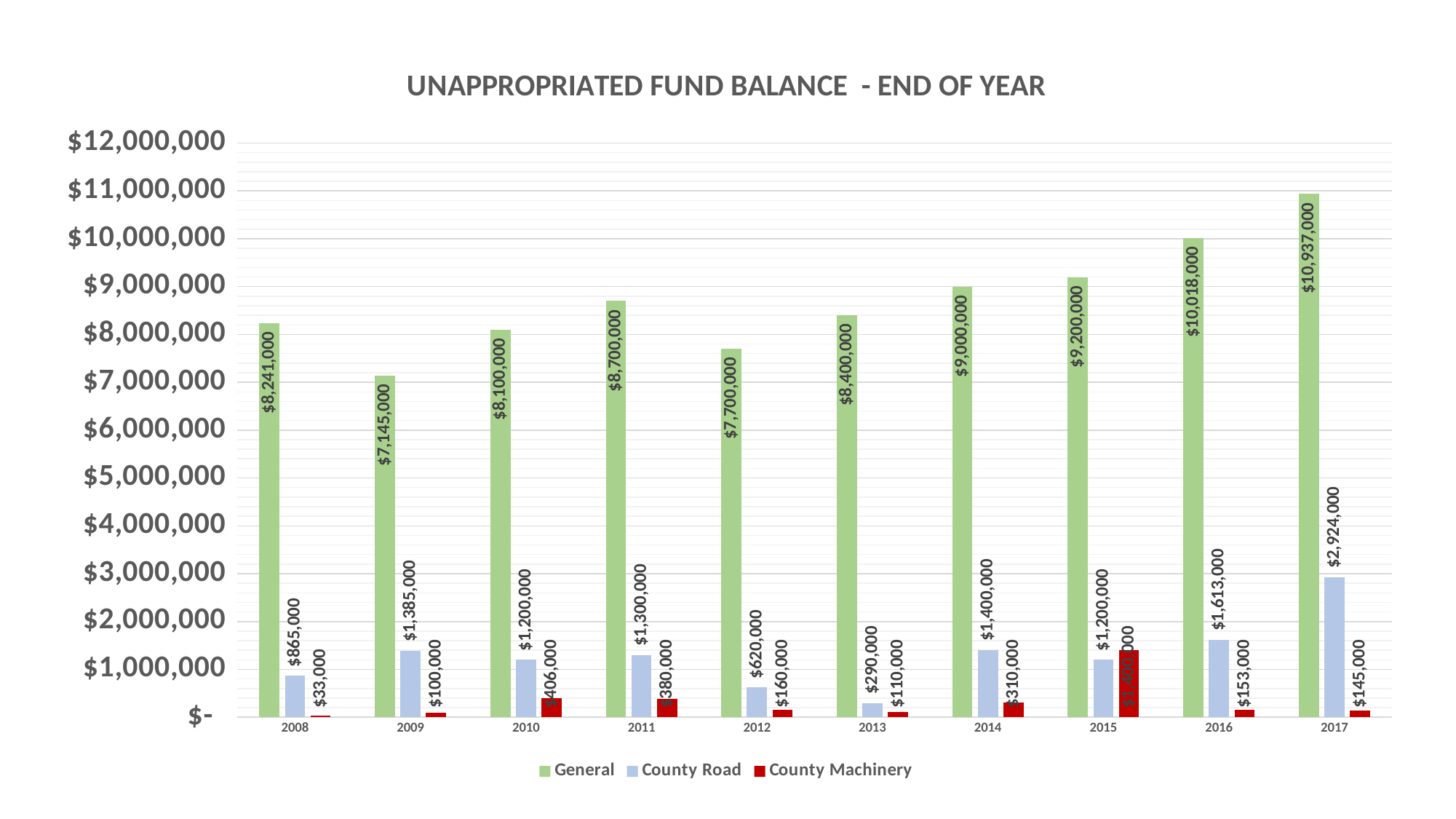
Which is larger, the County Road balance in 2009 or in 2014? 2014 What type of chart is shown on the slide? bar chart In which year is the County Machinery fund balance lowest? 2008 In which year is the General fund balance lowest? 2009 What is the difference between the General fund balance in 2017 and in 2016? $919,000 How many series does the legend list? 3 What is the County Machinery fund balance for 2010? $406,000 Is the General fund balance for 2016 greater or less than $10,000,000? greater In which year is the County Road fund balance highest? 2017 What is the County Road fund balance for 2013? $290,000 How many years are shown on the x axis? 10 What is the General fund balance for 2017? $10,937,000